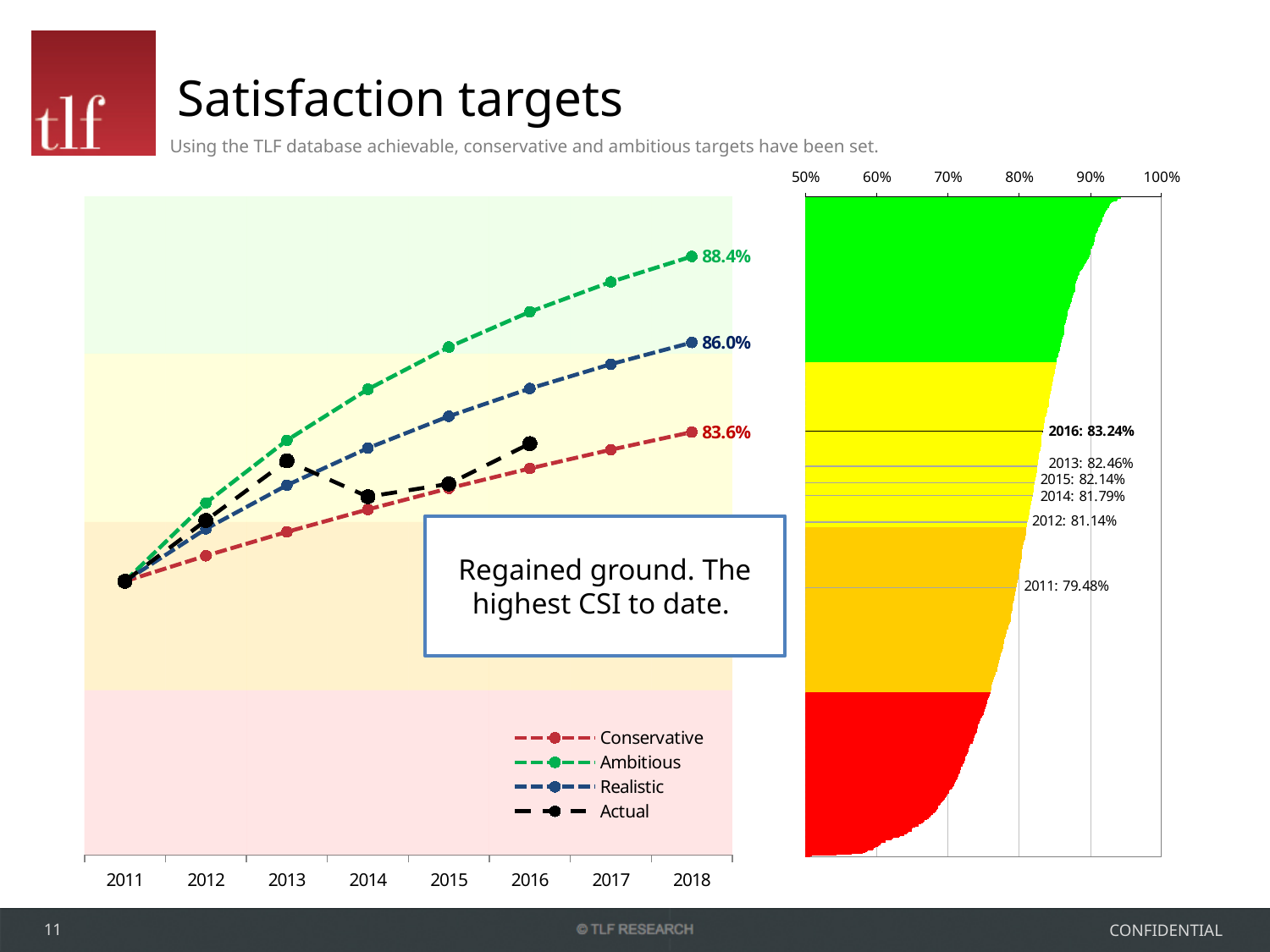
On the left line chart, which series has the highest value in 2018? Ambitious What kind of chart is the left chart? Line chart On the left line chart, what is the 2018 value shown for the Conservative series? 83.6% On the right chart, what value is labelled for 2016? 83.24% On the left line chart, what is the 2018 value shown for the Realistic series? 86.0% How many years are shown on the x axis of the left chart? 8 On the right chart, which labelled year has the lowest value? 2011 On the left line chart, what is the 2018 value shown for the Ambitious series? 88.4% How many series does the legend of the left chart list? 4 On the right chart, what is the difference between the 2016 value and the 2011 value? 3.76 percentage points On the left line chart, does the Ambitious series rise or fall from 2011 to 2018? Rises On the left line chart, what is the difference between the 2018 Ambitious value and the 2018 Conservative value? 4.8 percentage points